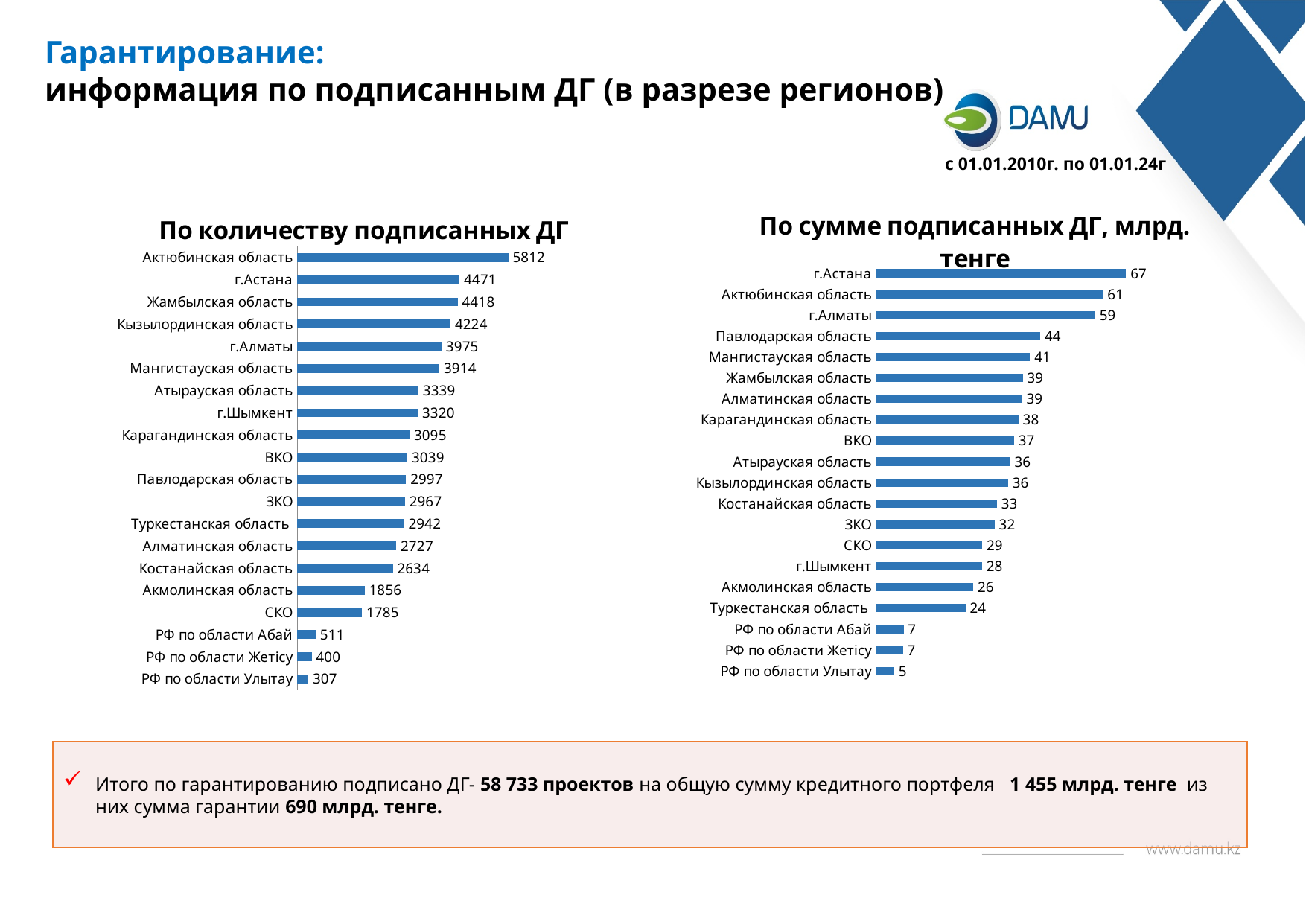
In the chart 'По количеству подписанных ДГ', which region has the highest value? Актюбинская область In the chart 'По количеству подписанных ДГ', what is the difference between г.Астана and г.Алматы? 496 In the chart 'По сумме подписанных ДГ, млрд. тенге', which region has the highest value? г.Астана What type of chart is 'По количеству подписанных ДГ'? Bar chart In the chart 'По количеству подписанных ДГ', which region has the lowest value? РФ по области Улытау In the chart 'По сумме подписанных ДГ, млрд. тенге', what is the value for Павлодарская область? 44 In the chart 'По количеству подписанных ДГ', what is the value for СКО? 1785 In the chart 'По сумме подписанных ДГ, млрд. тенге', which region has the lowest value? РФ по области Улытау In the chart 'По количеству подписанных ДГ', what is the value for Кызылординская область? 4224 In the chart 'По сумме подписанных ДГ, млрд. тенге', which is larger: ВКО or ЗКО? ВКО In the chart 'По сумме подписанных ДГ, млрд. тенге', what is the difference between г.Астана and Туркестанская область? 43 In the chart 'По количеству подписанных ДГ', how many regions are shown? 20